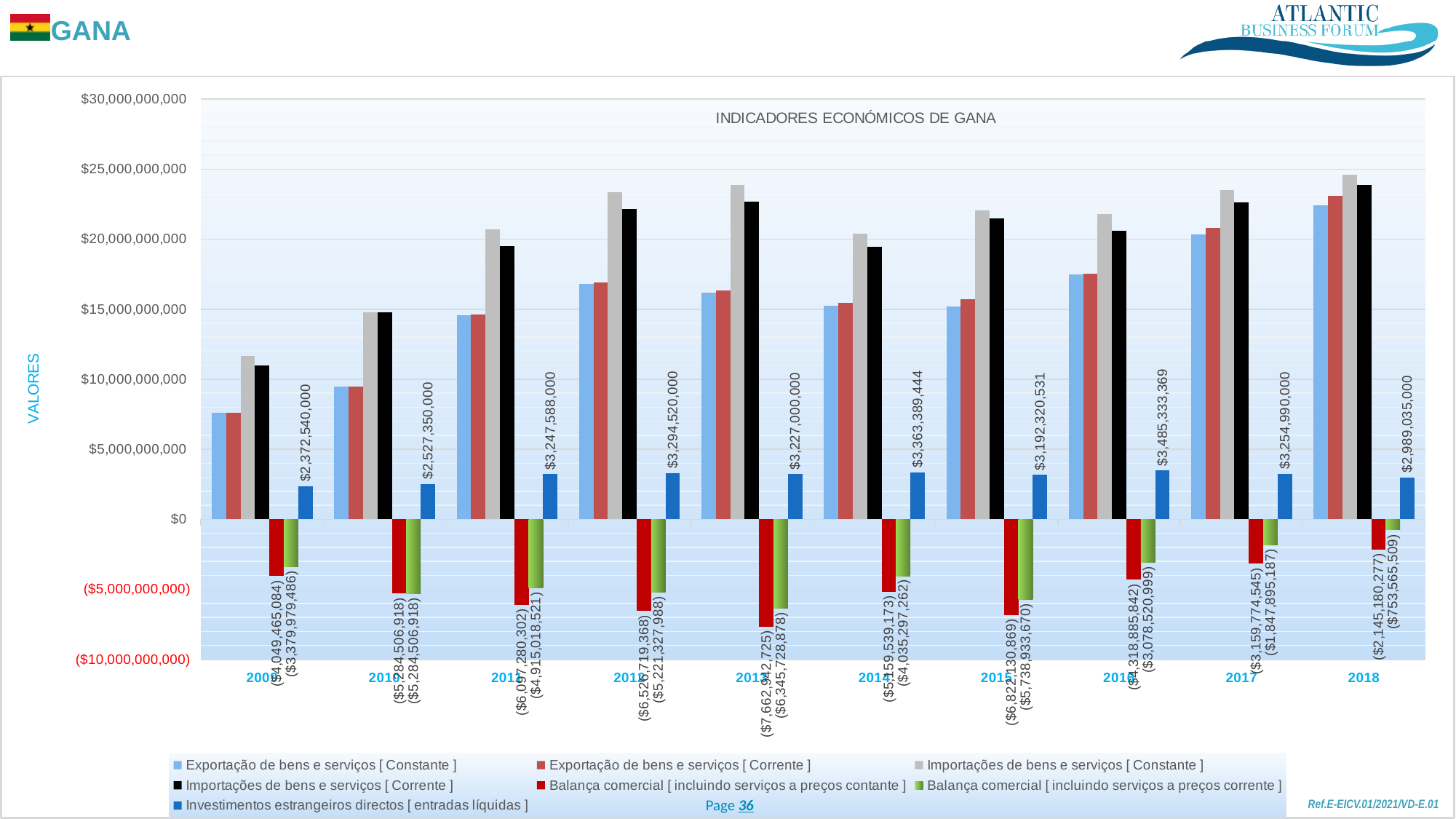
What is the value of Balança comercial [incluindo serviços a preços contante] in 2017? ($3,159,774,545) Is the value for Importações de bens e serviços [Constante] in 2012 greater or less than $20,000,000,000? greater What is the value of Investimentos estrangeiros directos [entradas líquidas] in 2016? $3,485,333,369 Which year has the higher value for Importações de bens e serviços [Constante], 2013 or 2014? 2013 In which year is Investimentos estrangeiros directos [entradas líquidas] lowest? 2009 Is the value for Exportação de bens e serviços [Constante] in 2009 greater or less than $10,000,000,000? less What is the difference between Investimentos estrangeiros directos [entradas líquidas] in 2012 and in 2011? $46,932,000 How many series does the legend list? 7 What kind of chart is shown on the slide? bar chart How many years are shown on the x axis of the chart? 10 What is the value of Balança comercial [incluindo serviços a preços corrente] in 2018? ($753,565,509) In which year is Investimentos estrangeiros directos [entradas líquidas] highest? 2016